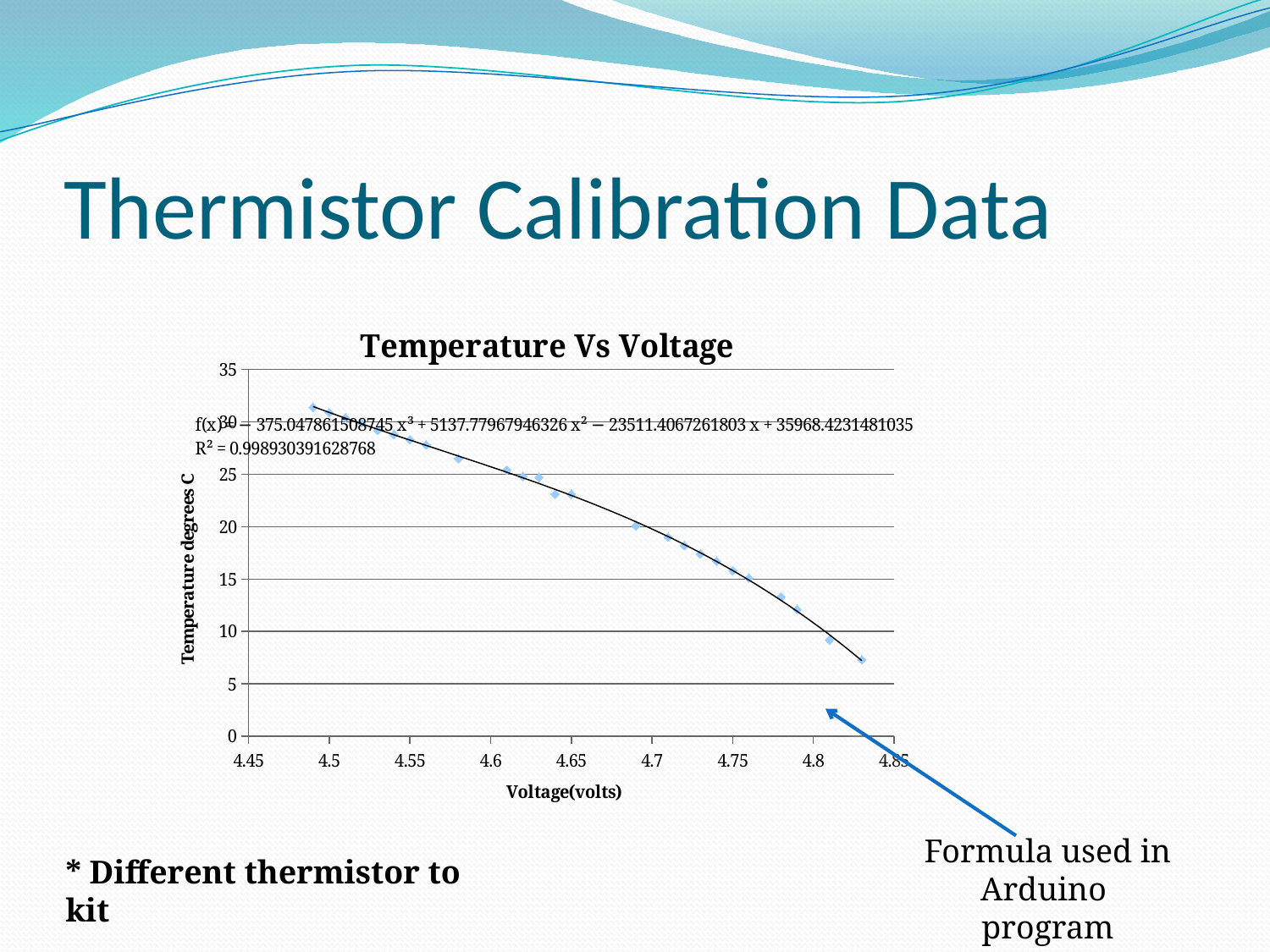
What R² value is printed on the chart for the fitted curve? R² = 0.998930391628768 Which has the higher temperature, the leftmost data point or the rightmost data point? the leftmost data point What is the title of the chart? Temperature Vs Voltage Do the temperature values rise or fall as voltage increases along the x axis? fall Is the temperature at about 4.75 volts greater or less than 20? less Is the temperature at about 4.65 volts greater or less than 15? greater Is the temperature at the rightmost data point (about 4.83 volts) greater or less than 10? less What kind of chart is shown on the slide? scatter chart